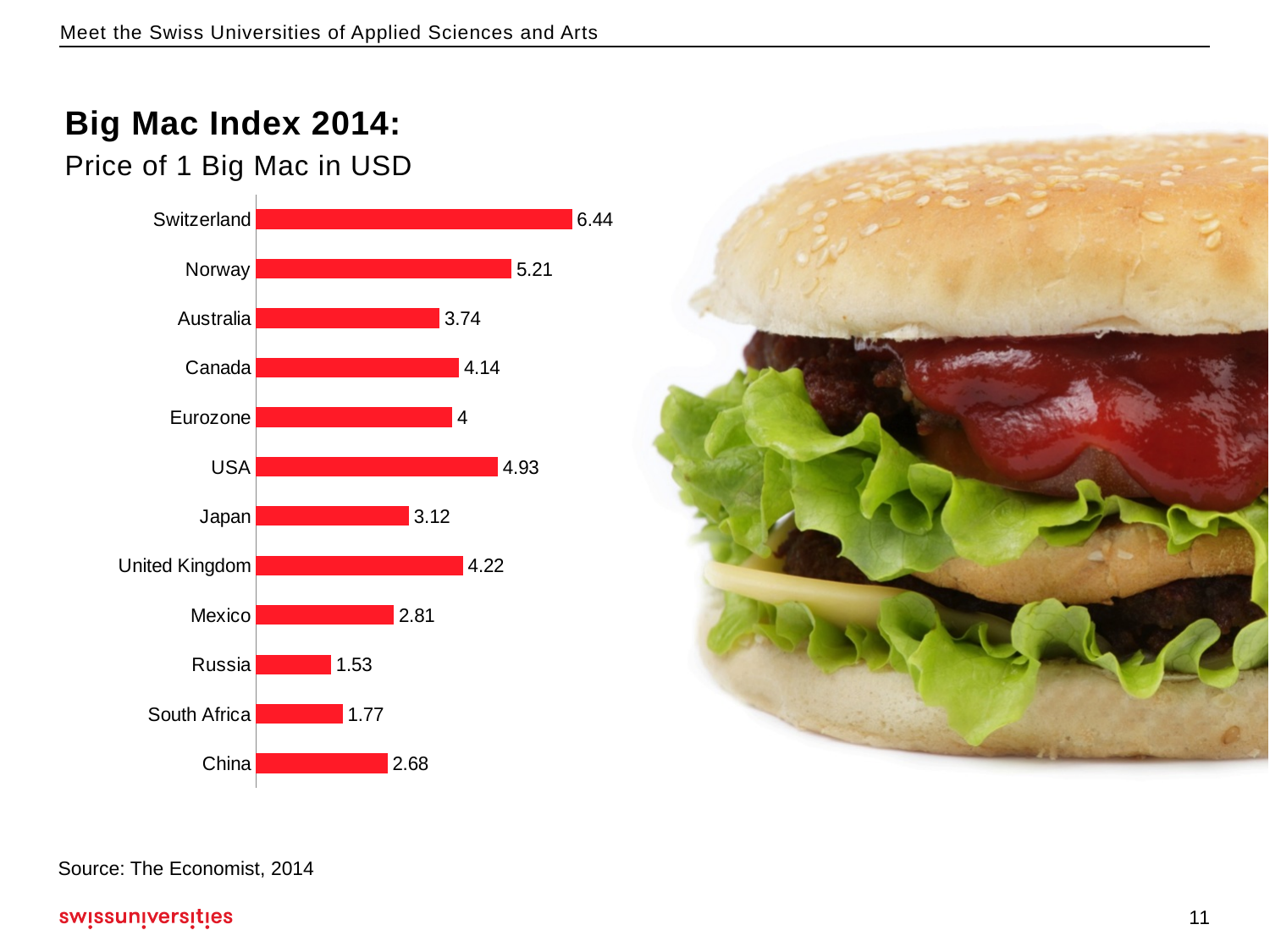
Which has a higher value, Canada or the United Kingdom? United Kingdom What kind of chart is shown on the slide? Bar chart How many countries or regions are shown in the chart? 12 What is the source cited for the chart data? The Economist, 2014 What is the difference between the values for Switzerland and Norway? 1.23 What is the value shown for the Eurozone? 4 Which country has the highest Big Mac price? Switzerland Which country has the lowest Big Mac price? Russia Which has a lower value, Russia or South Africa? Russia What is the price of a Big Mac in USD for Switzerland? 6.44 What is the difference between the values for the USA and China? 2.25 What is the value shown for Japan? 3.12